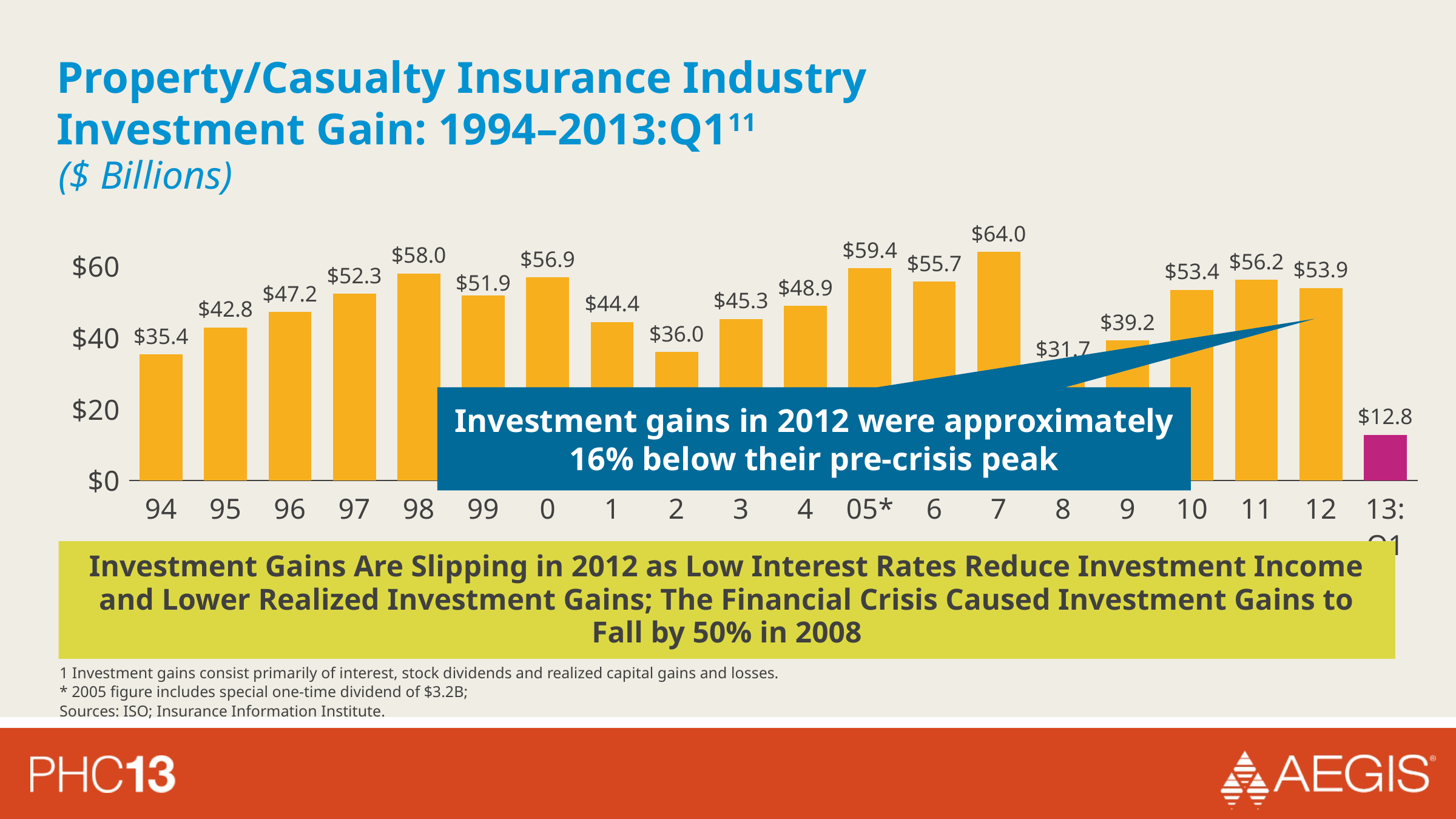
What was the investment gain in 2008? $31.7 What is the difference between the investment gain in 2007 and in 2008? $32.3 Do the values rise or fall from 2008 to 2011? rise Which bar has the lowest value on the chart? 13:Q1 What was the investment gain in 2007? $64.0 Which year has the highest investment gain? 2007 Is the value for 1994 greater or less than $40? less What value is shown for 2013:Q1? $12.8 Which bar is shown in a different colour from the others? 13:Q1 Which year had a larger investment gain, 2011 or 2012? 2011 What kind of chart is shown on the slide? bar chart How many bars are plotted on the chart? 20